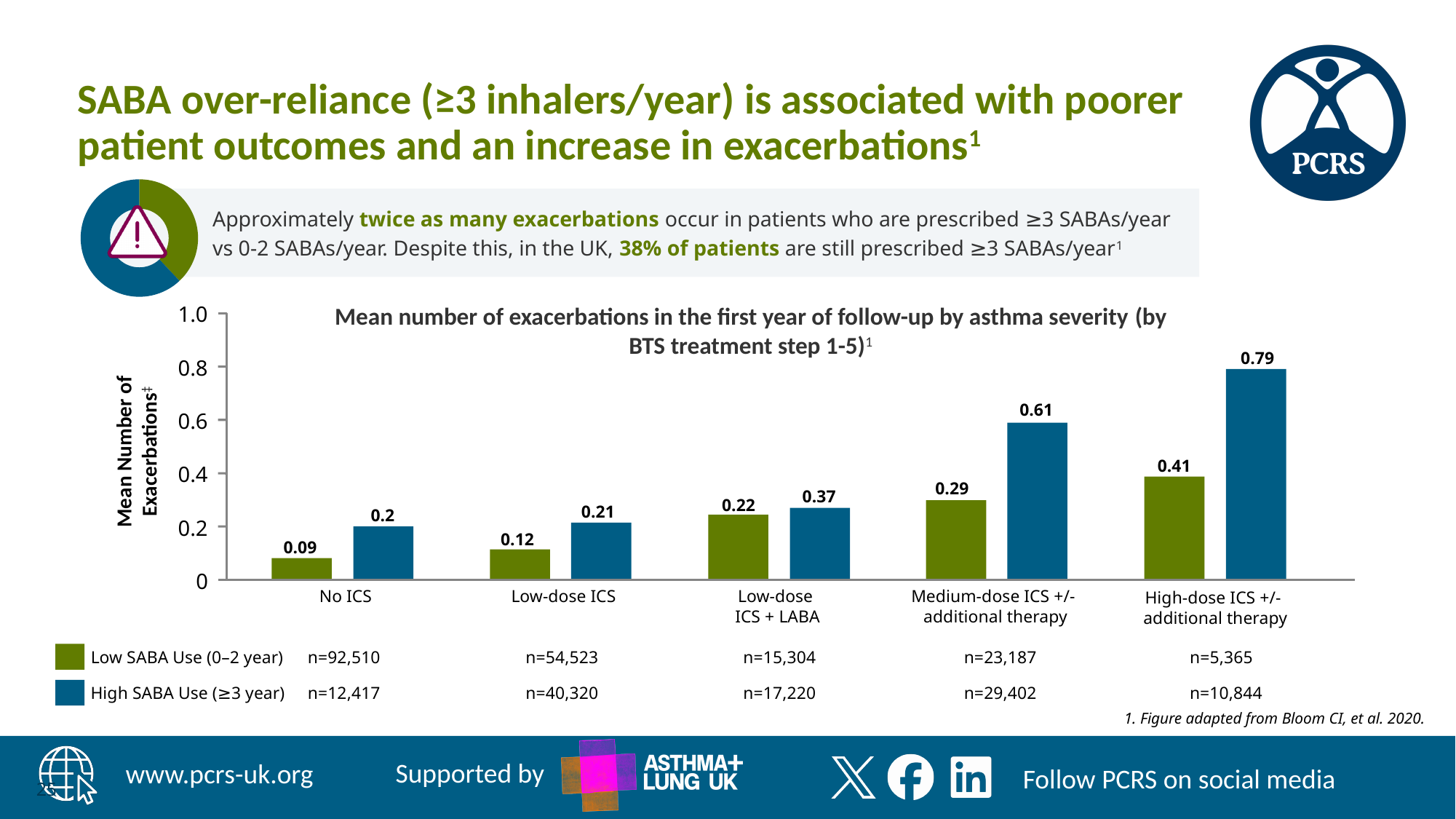
What is the difference between High SABA Use and Low SABA Use mean exacerbations in the Medium-dose ICS +/- additional therapy group? 0.32 What is the mean number of exacerbations for High SABA Use in the High-dose ICS +/- additional therapy group? 0.79 In the Low-dose ICS group, which is larger: the Low SABA Use value or the High SABA Use value? High SABA Use How many series does the legend list? 2 Do the High SABA Use values rise or fall from No ICS to High-dose ICS +/- additional therapy? Rise Which treatment group has the highest mean number of exacerbations for High SABA Use? High-dose ICS +/- additional therapy How many treatment groups are shown on the x axis? 5 What is the mean number of exacerbations for Low SABA Use in the No ICS group? 0.09 Which treatment group has the lowest mean number of exacerbations for Low SABA Use? No ICS Is the High SABA Use value for the High-dose ICS +/- additional therapy group greater or less than 0.6? greater What kind of chart is shown on the slide? Bar chart What is the mean number of exacerbations for High SABA Use in the Low-dose ICS + LABA group? 0.37